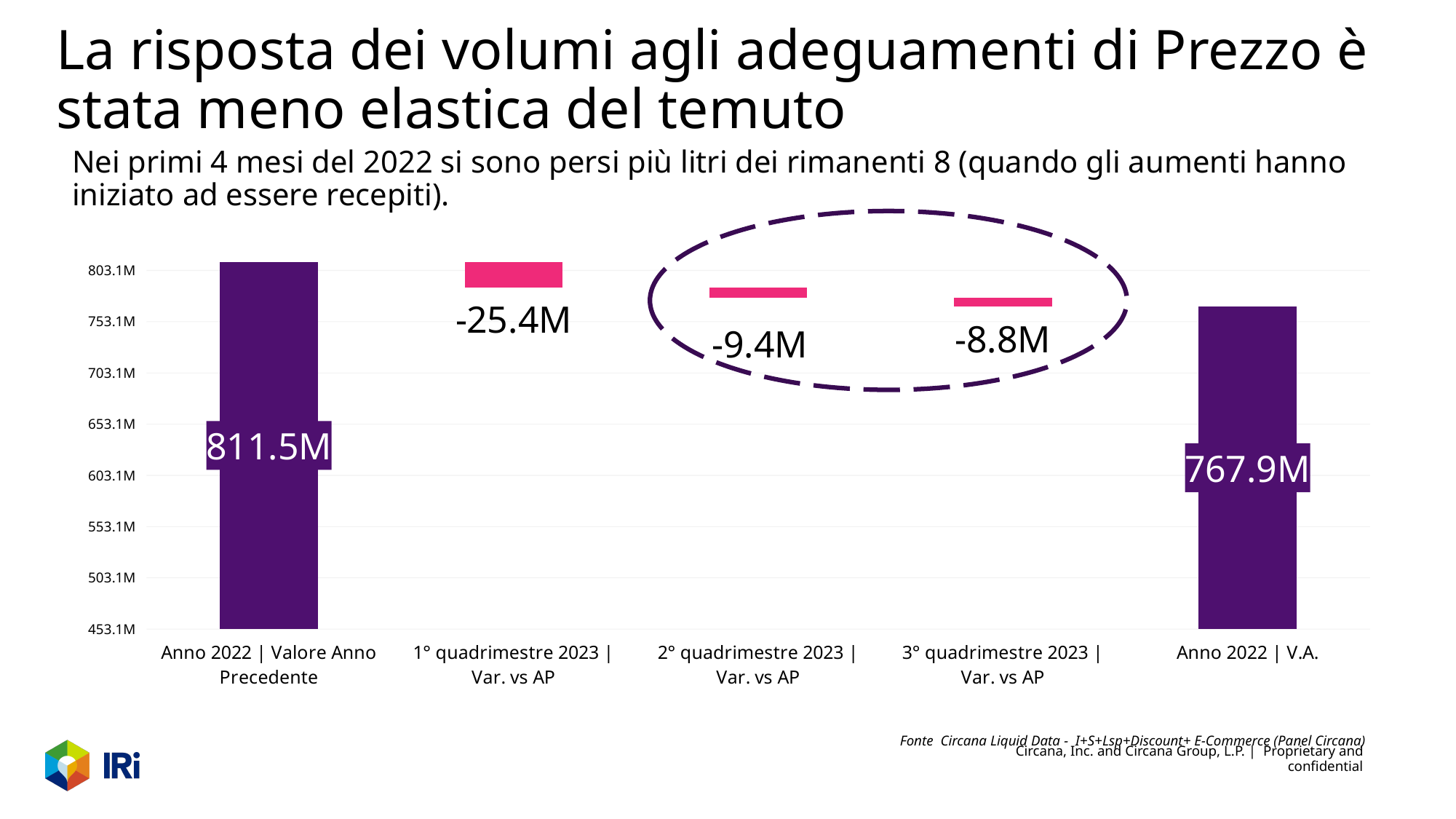
Which quadrimestre of 2023 shows the smallest decrease vs AP? 3° quadrimestre 2023 What kind of chart is shown on the slide? bar chart Is the decrease in the 2° quadrimestre 2023 larger or smaller than the decrease in the 3° quadrimestre 2023? larger What is the variation shown for '2° quadrimestre 2023 | Var. vs AP'? -9.4M What is the variation shown for '1° quadrimestre 2023 | Var. vs AP'? -25.4M What is the variation shown for '3° quadrimestre 2023 | Var. vs AP'? -8.8M What is the difference between the 'Anno 2022 | Valore Anno Precedente' value and the 'Anno 2022 | V.A.' value? 43.6M How many categories are shown on the x axis of the chart? 5 Which quadrimestre of 2023 shows the largest decrease vs AP? 1° quadrimestre 2023 What is the value shown for 'Anno 2022 | V.A.'? 767.9M What is the value shown for 'Anno 2022 | Valore Anno Precedente'? 811.5M What colour are the bars representing the quadrimestre variations? pink